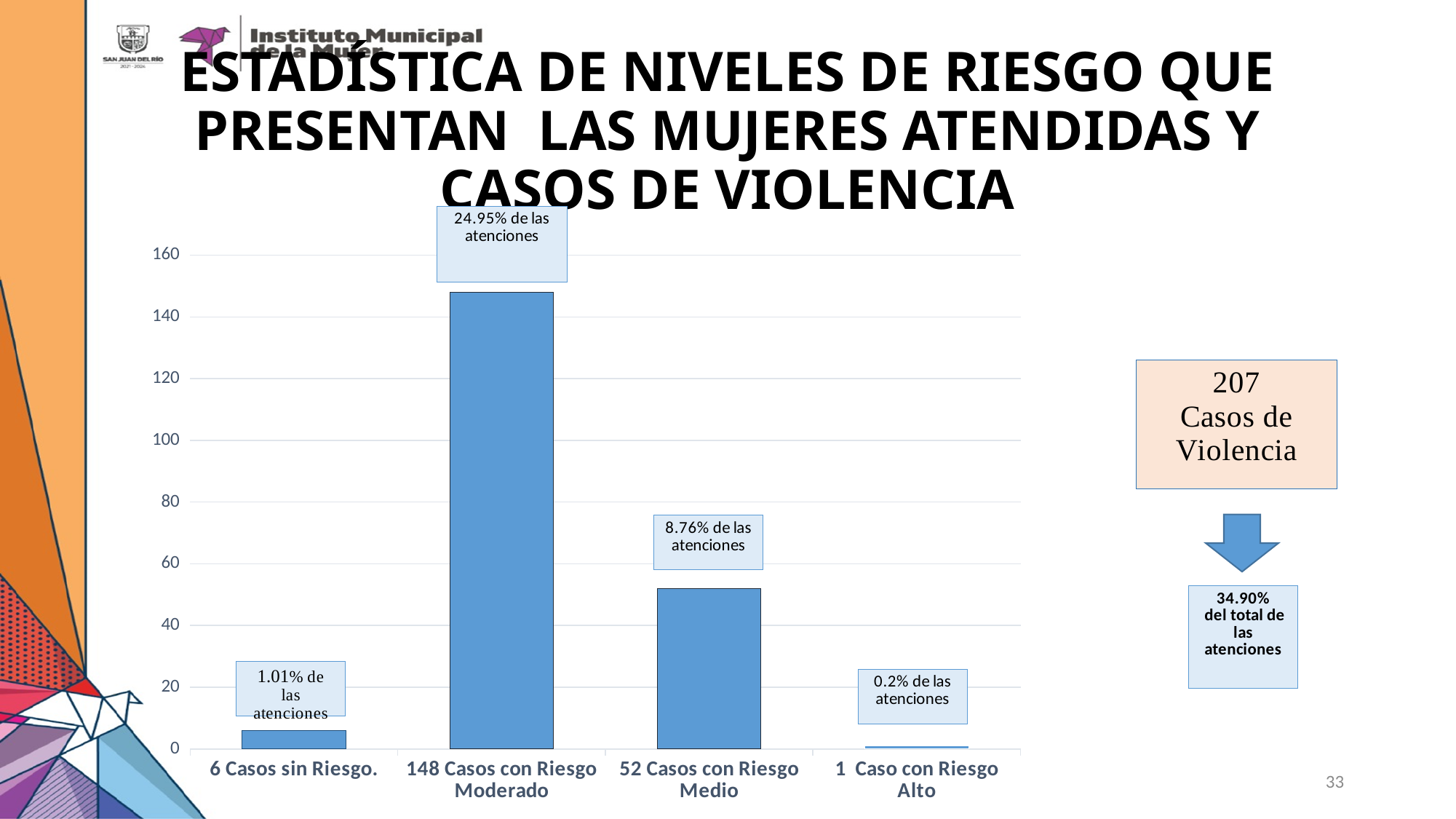
According to the box to the right of the chart, what is the total number of 'Casos de Violencia'? 207 Which category has the lowest number of cases? 1 Caso con Riesgo Alto What percentage of the atenciones do the 'Casos sin Riesgo' represent, according to the label above that bar? 1.01% de las atenciones Is the value for 'Casos con Riesgo Moderado' greater or less than 140? greater Which category has the highest number of cases? 148 Casos con Riesgo Moderado Which is larger: the number of 'Casos sin Riesgo' or the number of 'Casos con Riesgo Medio'? Casos con Riesgo Medio What kind of chart is shown on the slide? bar chart How many categories (bars) does the chart show? 4 What percentage of the atenciones do the 'Casos con Riesgo Moderado' represent, according to the label above that bar? 24.95% de las atenciones What is the difference between the number of cases with Riesgo Moderado and the number with Riesgo Medio? 96 How many cases are reported for 'Casos con Riesgo Moderado'? 148 How many cases are reported for 'Casos con Riesgo Medio'? 52